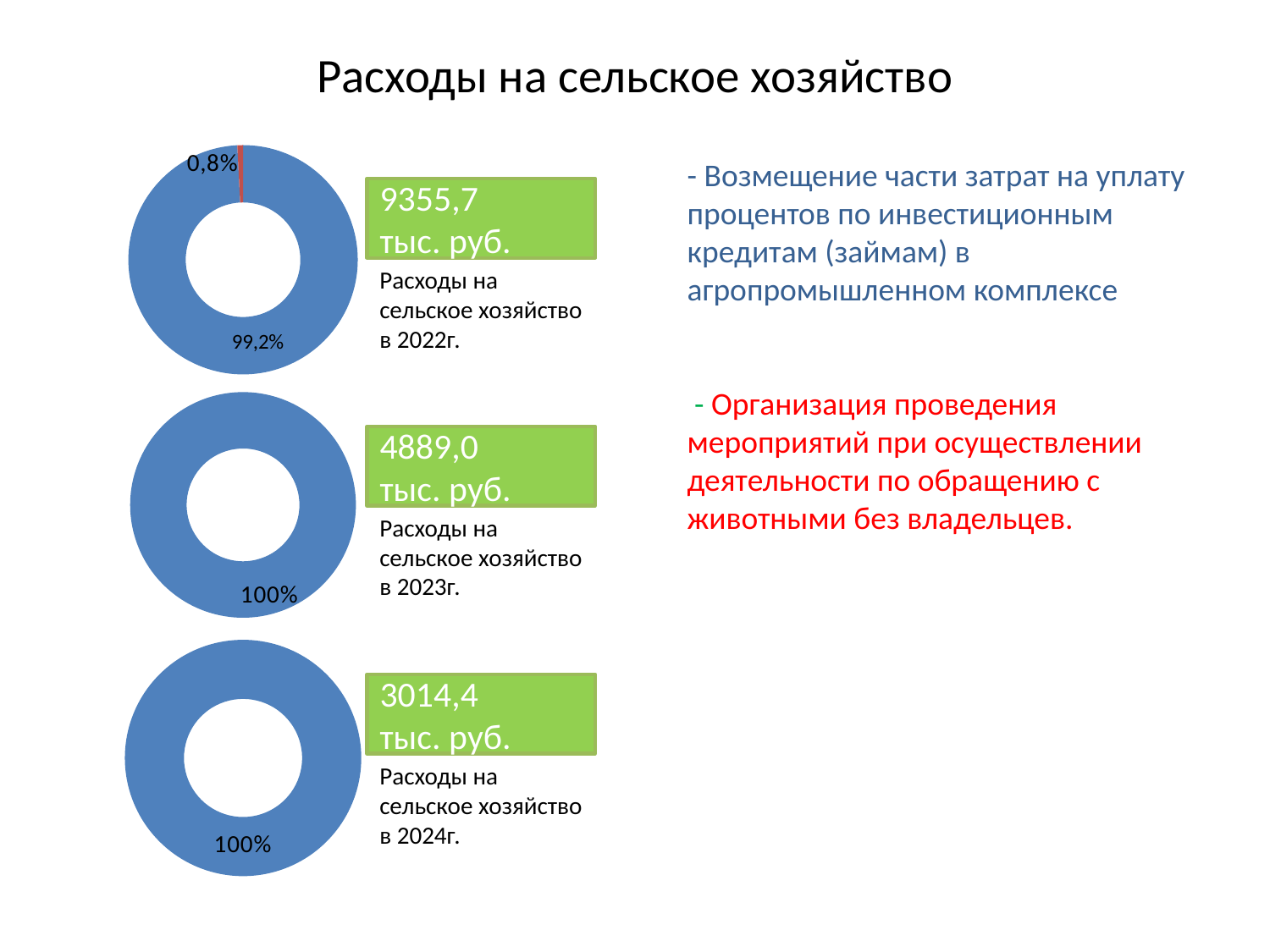
In the top chart (2022), what is the difference between the blue slice's share and the red slice's share? 98,4% In the bottom chart (Расходы на сельское хозяйство в 2024г.), what share is shown for the blue slice? 100% How many doughnut charts are shown on the slide? 3 In the top chart (Расходы на сельское хозяйство в 2022г.), what share does the small red slice have? 0,8% What is the title of the slide containing the three doughnut charts? Расходы на сельское хозяйство In the top chart (2022), which slice is larger, the blue one or the red one? The blue one In the middle chart (Расходы на сельское хозяйство в 2023г.), what share is shown for the blue slice? 100% What kind of chart is used for the 2022 agricultural expenditure (top chart)? Doughnut chart What total amount is printed in the green box next to the 2022 chart? 9355,7 тыс. руб. How many slices are visible in the top chart (2022)? 2 How many slices are visible in the middle chart (2023)? 1